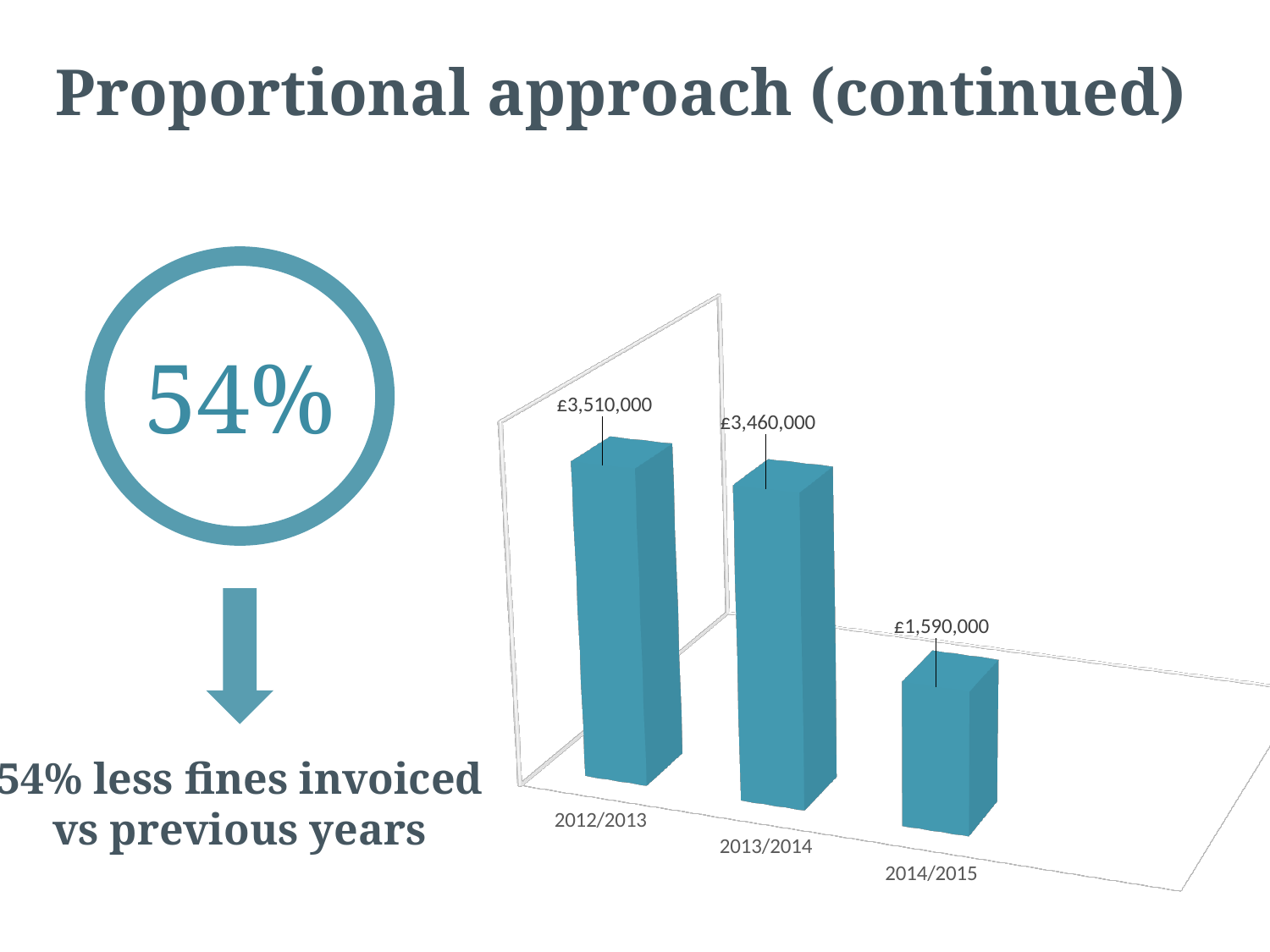
What is the difference between the values for 2013/2014 and 2014/2015? £1,870,000 Do the values rise or fall from 2012/2013 to 2014/2015? fall What kind of chart is shown on the slide? bar chart Which year has the highest value? 2012/2013 Which is larger, the value for 2013/2014 or the value for 2014/2015? 2013/2014 What is the value for 2013/2014? £3,460,000 What is the difference between the values for 2012/2013 and 2013/2014? £50,000 How many categories are shown in the chart? 3 Which year has the lowest value? 2014/2015 What is the value for 2012/2013? £3,510,000 What is the value for 2014/2015? £1,590,000 What percentage is shown in the circle to the left of the chart? 54%